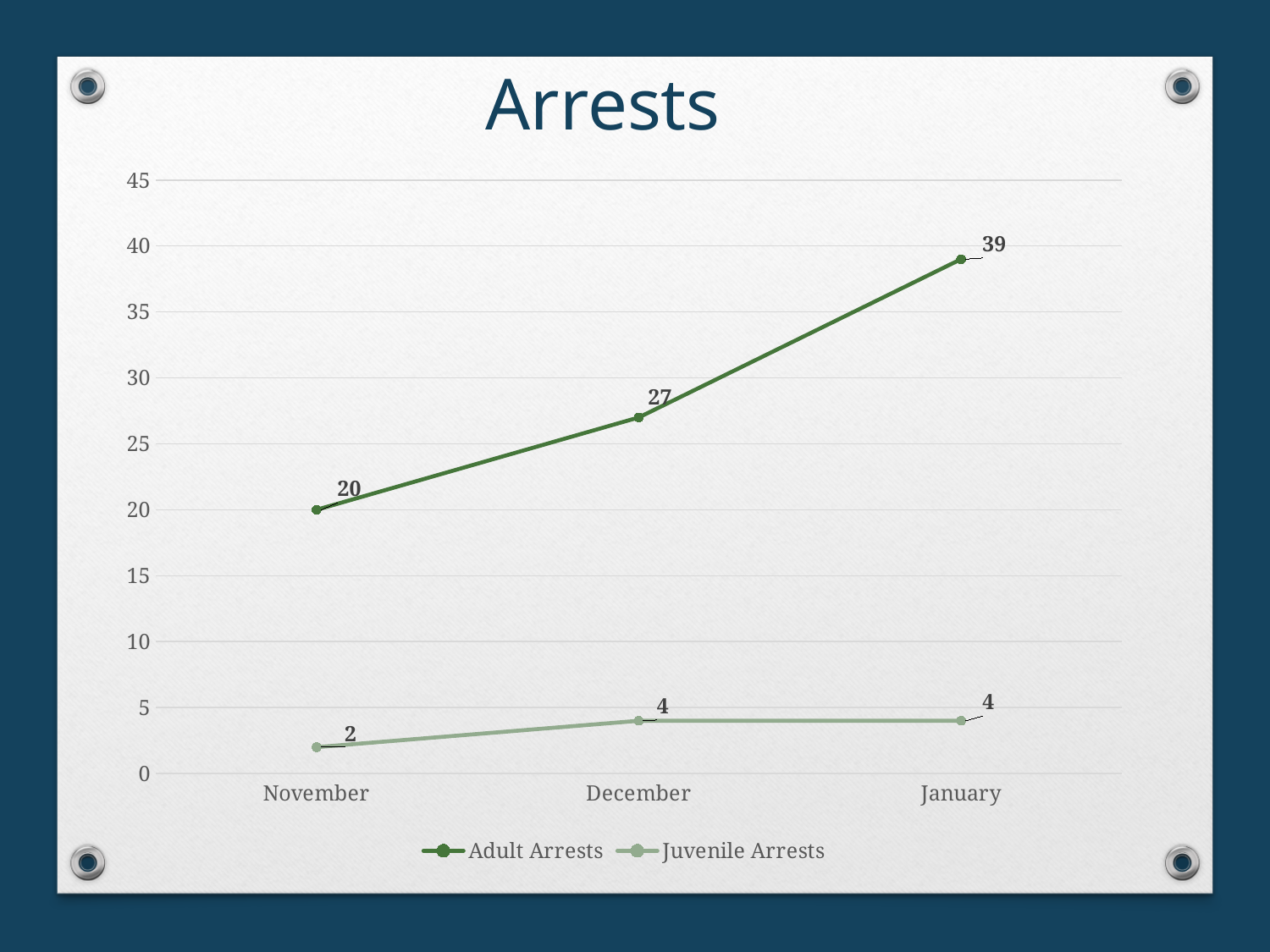
What kind of chart is shown on the slide? Line chart Is the value for Adult Arrests in January greater or less than 35? greater In which month are Juvenile Arrests lowest? November Which is larger: Adult Arrests in November or Adult Arrests in December? Adult Arrests in December What is the value for Juvenile Arrests in November? 2 What is the difference between Adult Arrests in January and in November? 19 In which month are Adult Arrests highest? January How many months are shown on the x axis? 3 Do Adult Arrests rise or fall from November to January? Rise What is the value for Adult Arrests in January? 39 How many series does the legend list? 2 What is the value for Adult Arrests in December? 27